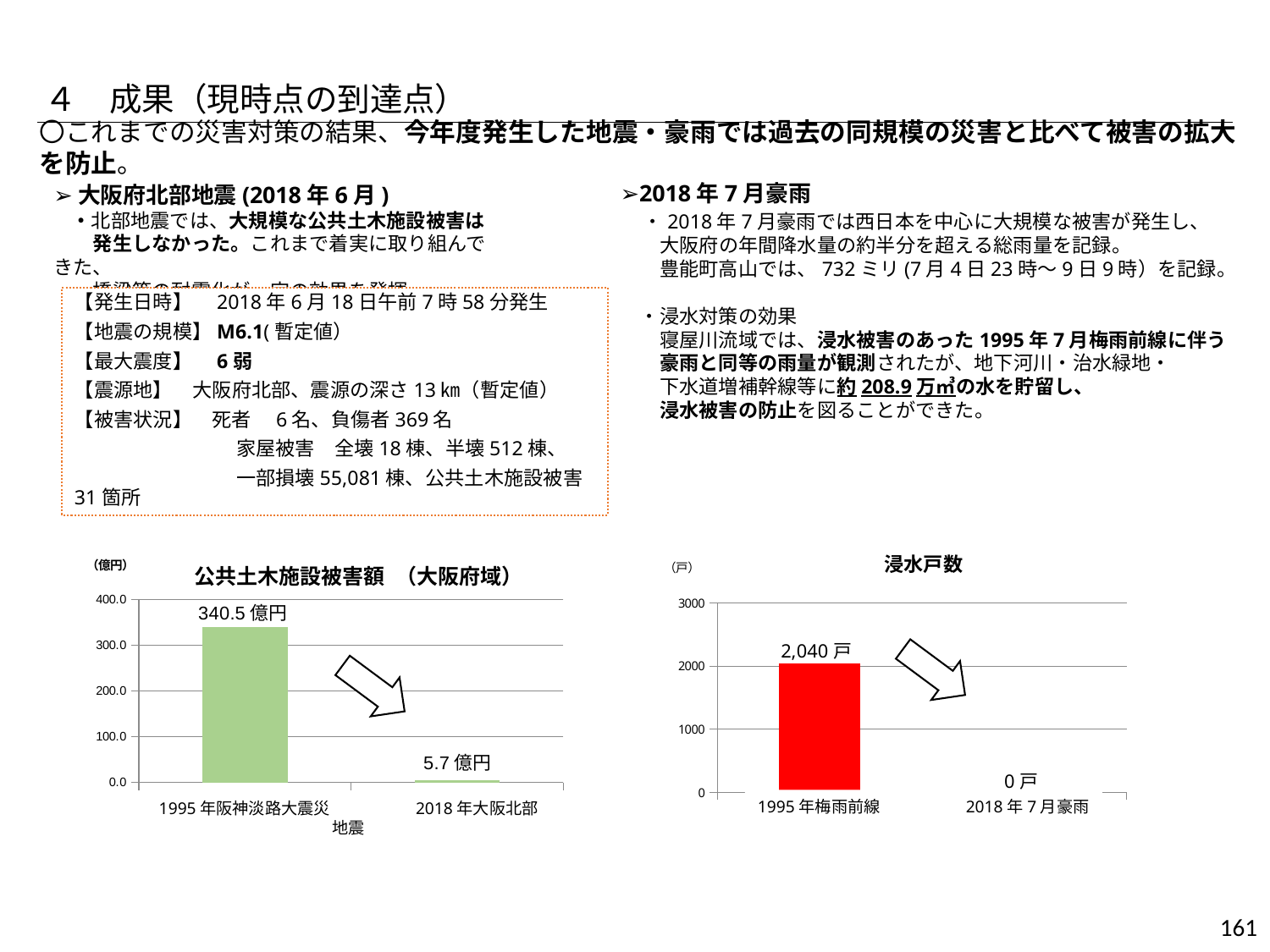
In the chart titled 公共土木施設被害額 （大阪府域）, what kind of chart is it? bar chart In the chart titled 浸水戸数, what unit is shown at the top of the vertical axis? (戸) In the chart titled 浸水戸数, which category has the lowest value? 2018年7月豪雨 In the chart titled 公共土木施設被害額 （大阪府域）, what is the difference between the 1995年阪神淡路大震災 value and the 2018年大阪北部地震 value? 334.8 億円 In the chart titled 浸水戸数, what is the value for 1995年梅雨前線? 2,040 戸 In the chart titled 公共土木施設被害額 （大阪府域）, which category has the highest value? 1995年阪神淡路大震災 In the chart titled 公共土木施設被害額 （大阪府域）, what is the value for 1995年阪神淡路大震災? 340.5 億円 In the chart titled 公共土木施設被害額 （大阪府域）, what is the value for 2018年大阪北部地震? 5.7 億円 In the chart titled 浸水戸数, do the values rise or fall from left to right along the x axis? fall In the chart titled 浸水戸数, is the value for 1995年梅雨前線 greater or less than 2000? greater In the chart titled 浸水戸数, what is the value for 2018年7月豪雨? 0 戸 In the chart titled 公共土木施設被害額 （大阪府域）, how many categories are shown on the x axis? 2